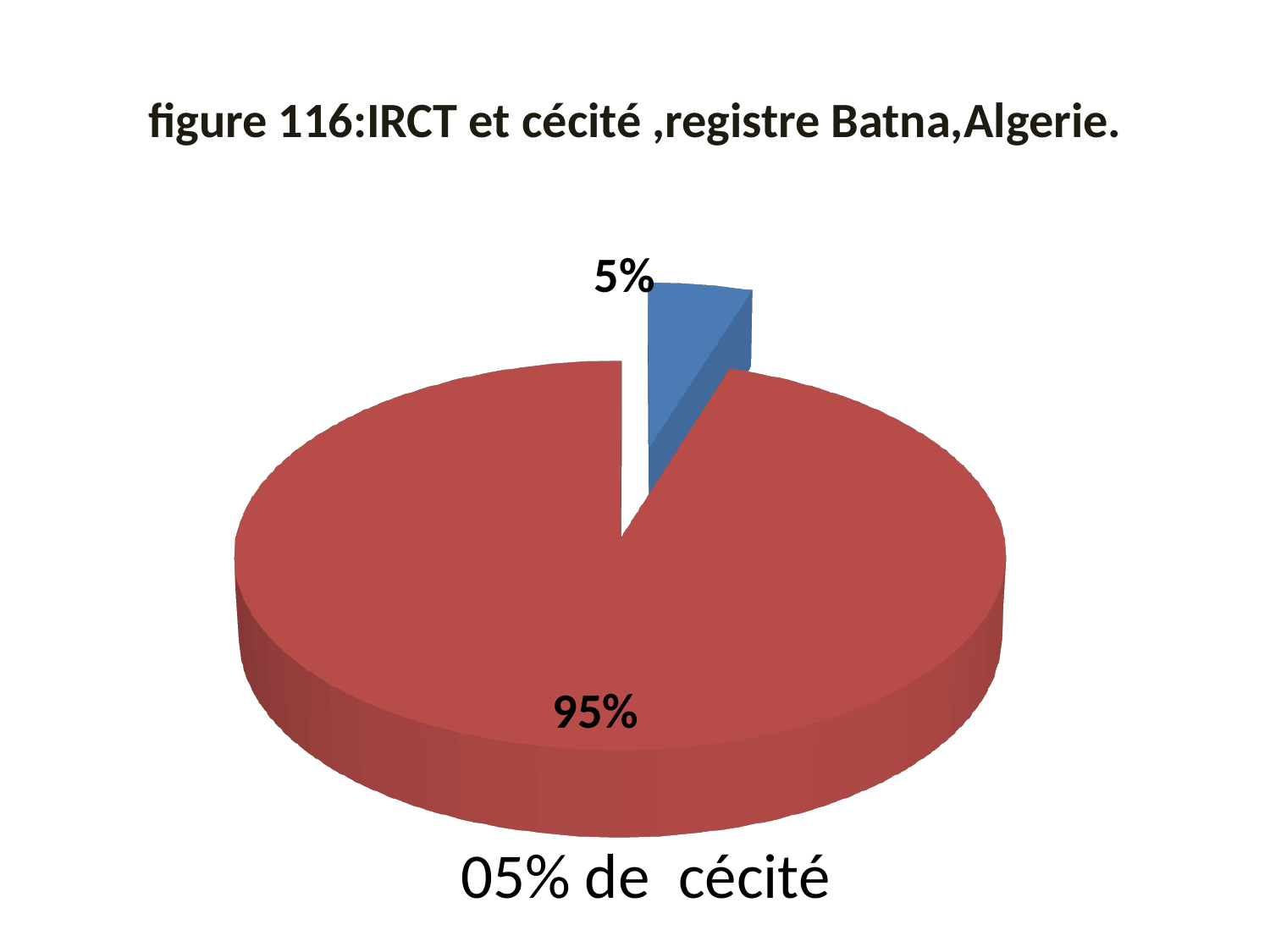
Which slice of the pie chart is the smallest? the blue slice (5%) Which slice is larger, the blue one or the red one? the red one What kind of chart is shown on the slide? pie chart How many slices does the pie chart have? 2 What is the title of the chart? figure 116:IRCT et cécité ,registre Batna,Algerie. What percentage is shown for the red slice of the pie chart? 95% What percentage is shown for the blue slice of the pie chart? 5% What share of the pie does the blue slice represent? 5% What does the caption below the pie chart say? 05% de cécité What is the difference in percentage points between the red slice and the blue slice? 90 Which slice of the pie chart is the largest? the red slice (95%)